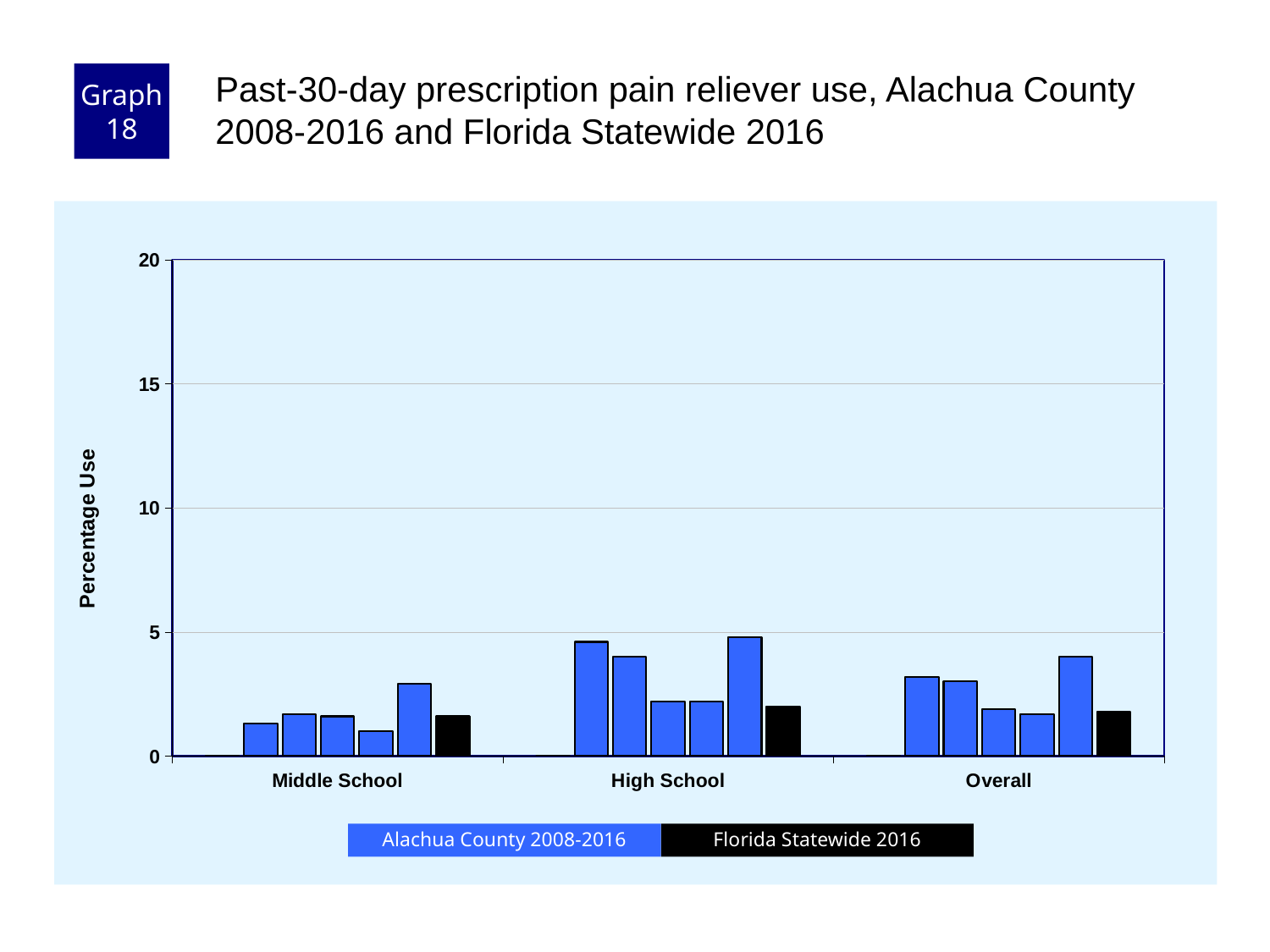
What is the highest value shown on the y axis? 20 Which category contains the tallest bar on the chart? High School Is the value for Florida Statewide 2016 in the Middle School category greater or less than 5? less Which colour represents Florida Statewide 2016 in the legend? black Is the value for Florida Statewide 2016 in the Overall category greater or less than 5? less What is the label of the y axis? Percentage Use How many series does the legend list? 2 How many categories are shown along the x axis? 3 What kind of chart is shown on the slide? bar chart For Florida Statewide 2016, which is larger: the High School value or the Middle School value? High School Is the value for Florida Statewide 2016 in the High School category greater or less than 5? less